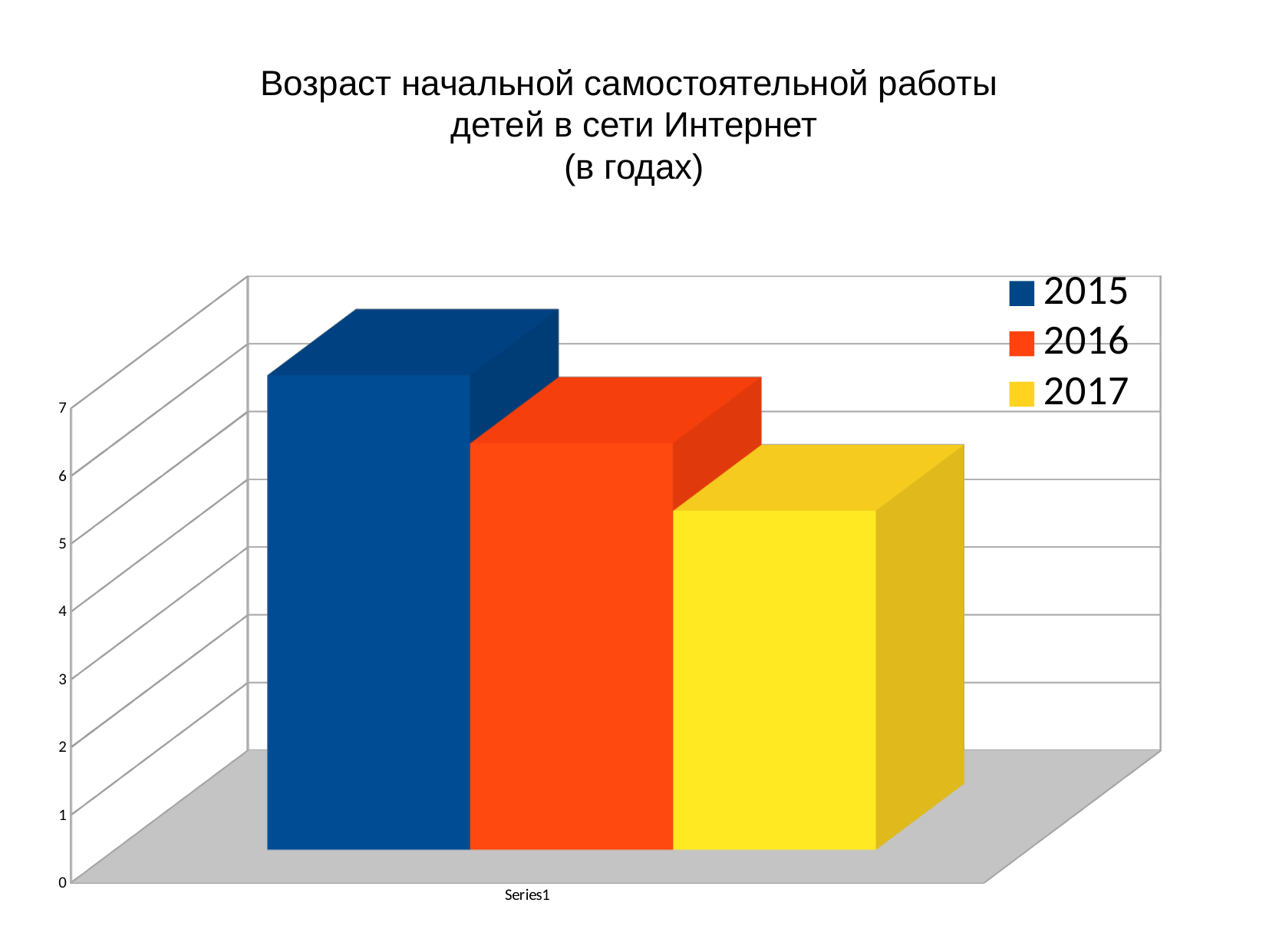
Is the value for 2017 greater or less than 6? less Do the values rise or fall from 2015 to 2017? fall What kind of chart is shown on the slide? bar chart What is the title of the chart? Возраст начальной самостоятельной работы детей в сети Интернет (в годах) What colour is the bar for 2017? yellow How many series does the legend list? 3 Which year has the lowest bar? 2017 Is the value for 2015 greater or less than 6? greater Which is larger, the value for 2016 or the value for 2017? 2016 Is the value for 2016 greater or less than 5? greater Which year has the highest bar? 2015 Which is larger, the value for 2015 or the value for 2017? 2015